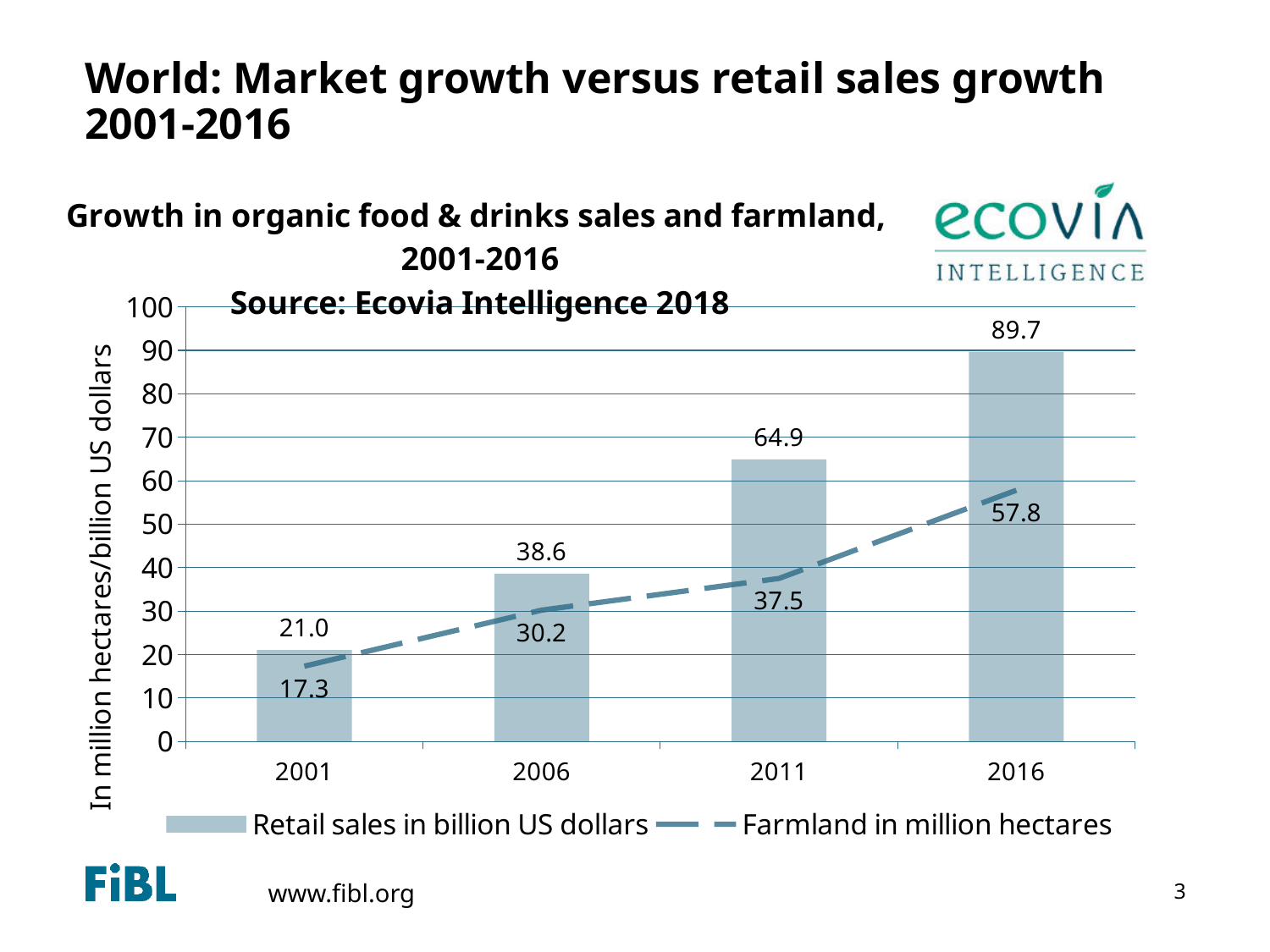
How many series does the legend list? 2 What is the difference between retail sales in 2016 and 2011, in billion US dollars? 24.8 Which year has the highest retail sales in billion US dollars? 2016 What is the retail sales value in billion US dollars for 2016? 89.7 What is the farmland value in million hectares for 2011? 37.5 Which year has the lowest farmland in million hectares? 2001 Which is larger in 2006: retail sales in billion US dollars or farmland in million hectares? Retail sales in billion US dollars What is the source given in the chart title? Ecovia Intelligence 2018 What is the farmland value in million hectares for 2001? 17.3 How many years are shown on the x axis? 4 Do the retail sales values rise or fall from 2001 to 2016? Rise What is the retail sales value in billion US dollars for 2006? 38.6